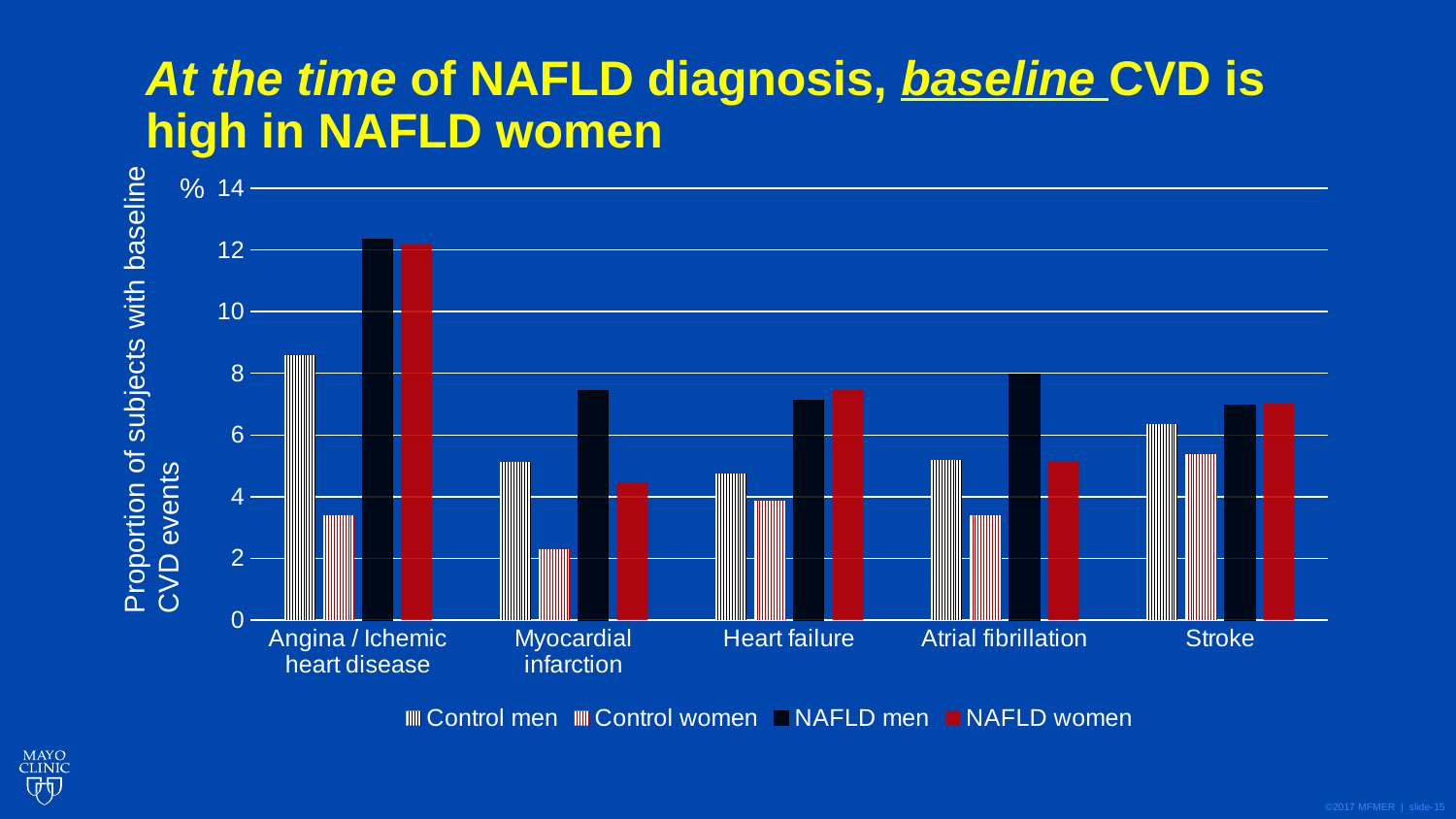
Which category has the lowest value for Control women? Myocardial infarction In Angina / Ichemic heart disease, which is larger: Control men or Control women? Control men How many series does the legend list? 4 Which category has the highest value for NAFLD women? Angina / Ichemic heart disease Which category has the highest value for Control men? Angina / Ichemic heart disease What is the label of the y axis? Proportion of subjects with baseline CVD events Is the value for Control women in Myocardial infarction greater or less than 4? less In Atrial fibrillation, which is larger: NAFLD men or NAFLD women? NAFLD men How many CVD event categories are shown on the x axis? 5 What kind of chart is shown on the slide? Bar chart Is the value for NAFLD men in Angina / Ichemic heart disease greater or less than 10? greater Is the value for NAFLD men in Atrial fibrillation greater or less than 6? greater